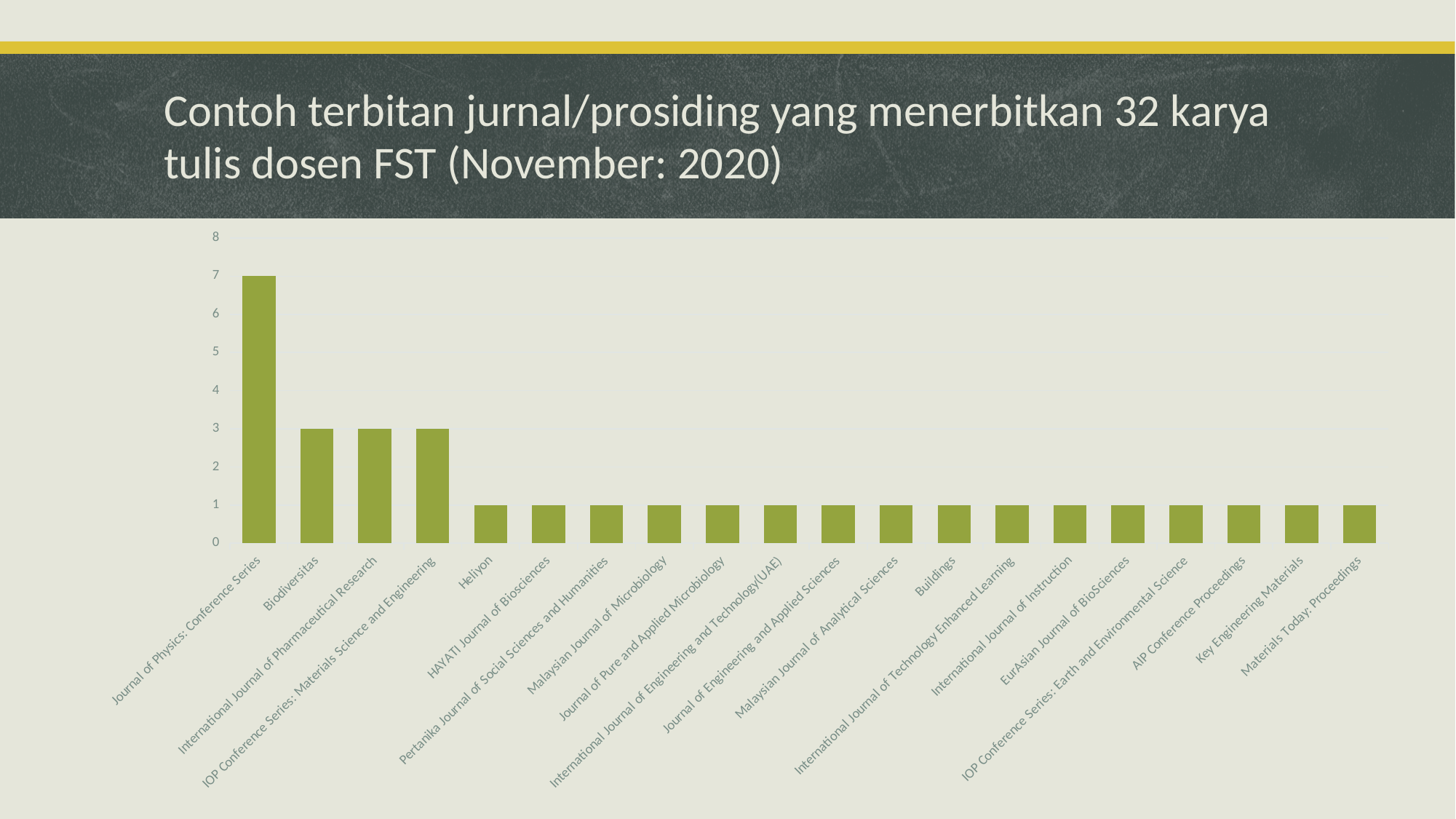
What is the value for Heliyon? 1 What is the value for Biodiversitas? 3 Is the value for Journal of Physics: Conference Series greater or less than 5? greater How many journals/proceedings are shown on the x axis of the chart? 20 What is the value for Journal of Physics: Conference Series? 7 What type of chart is shown on the slide? bar chart What colour are the bars in the chart? green Which journal/proceeding has the highest bar in the chart? Journal of Physics: Conference Series What is the value for IOP Conference Series: Materials Science and Engineering? 3 How many journals/proceedings in the chart have a value of 1? 16 What is the difference between the value for Journal of Physics: Conference Series and the value for International Journal of Pharmaceutical Research? 4 Which is larger, the value for Biodiversitas or the value for Buildings? Biodiversitas